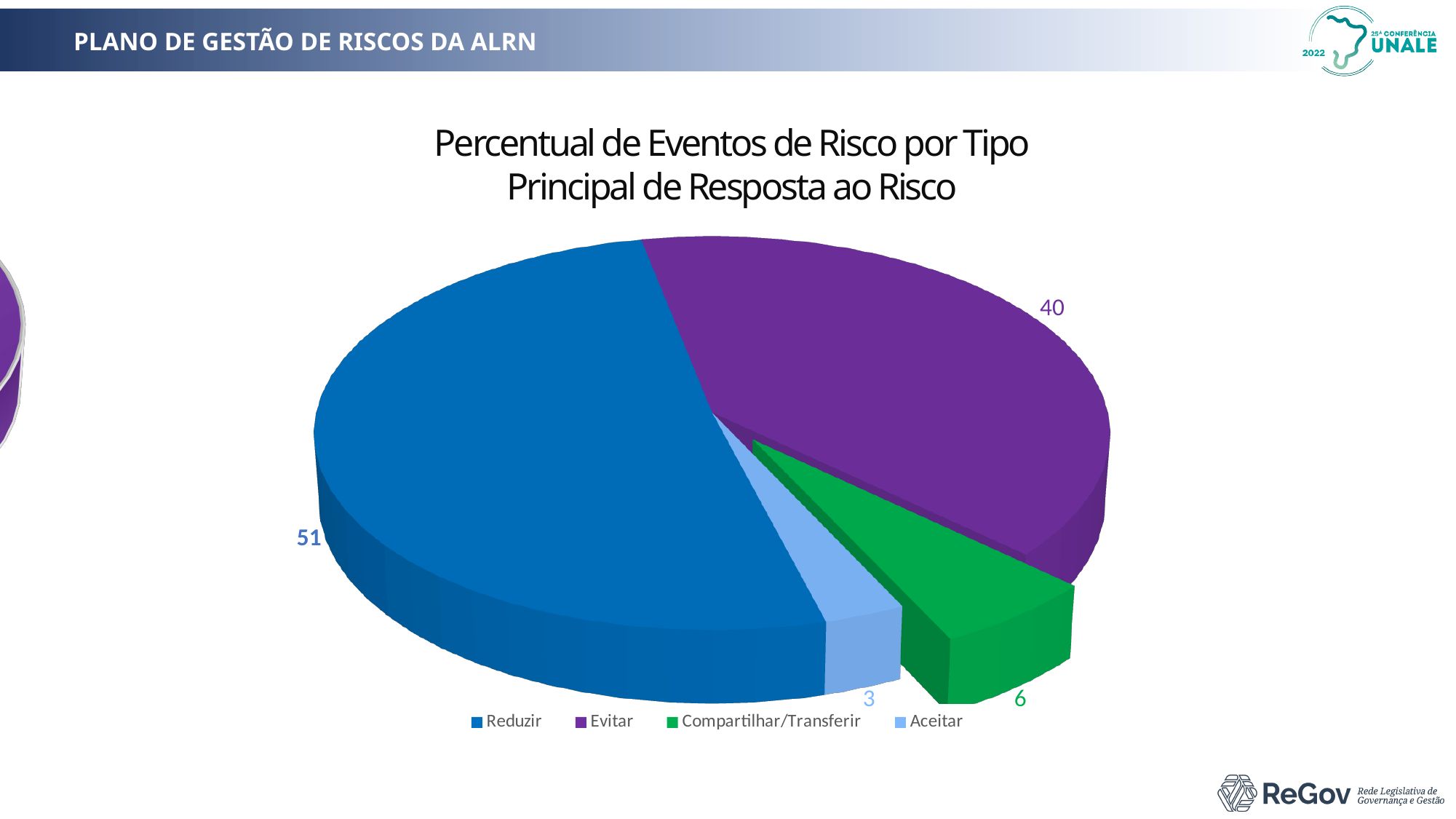
What is the value for Evitar in the pie chart? 40 What type of chart is shown on the slide? pie chart What is the title of the pie chart? Percentual de Eventos de Risco por Tipo Principal de Resposta ao Risco What is the value for Aceitar in the pie chart? 3 What is the value for Reduzir in the pie chart? 51 How many categories does the pie chart show? 4 What is the value for Compartilhar/Transferir in the pie chart? 6 Which is larger, the value for Compartilhar/Transferir or the value for Aceitar? Compartilhar/Transferir What share of the pie does Evitar represent? 40% Which category has the smallest slice in the pie chart? Aceitar Which category has the largest slice in the pie chart? Reduzir What is the difference between the values for Reduzir and Evitar? 11